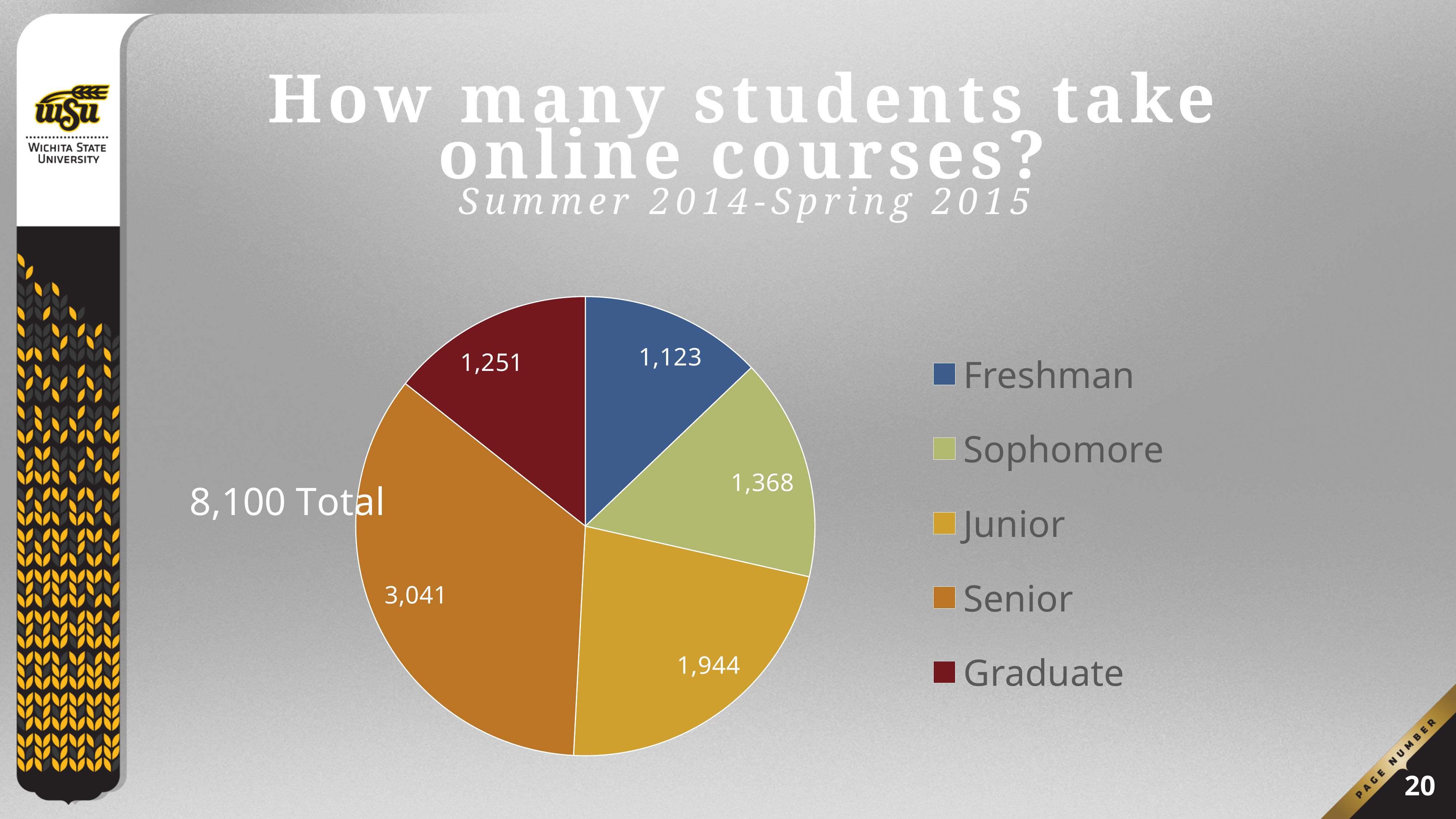
What is the value shown for the Freshman slice? 1,123 What is the difference between the Senior and Junior values? 1,097 Which category has the largest slice of the pie? Senior How many categories does the legend list? 5 What total is printed next to the pie chart? 8,100 Total How many students in the Senior category take online courses? 3,041 Which category has the smallest slice of the pie? Freshman What is the difference between the Sophomore and Freshman values? 245 What kind of chart is shown on the slide? pie chart What is the value shown for the Junior slice? 1,944 What is the value shown for the Graduate slice? 1,251 Which is larger, the Graduate value or the Freshman value? Graduate